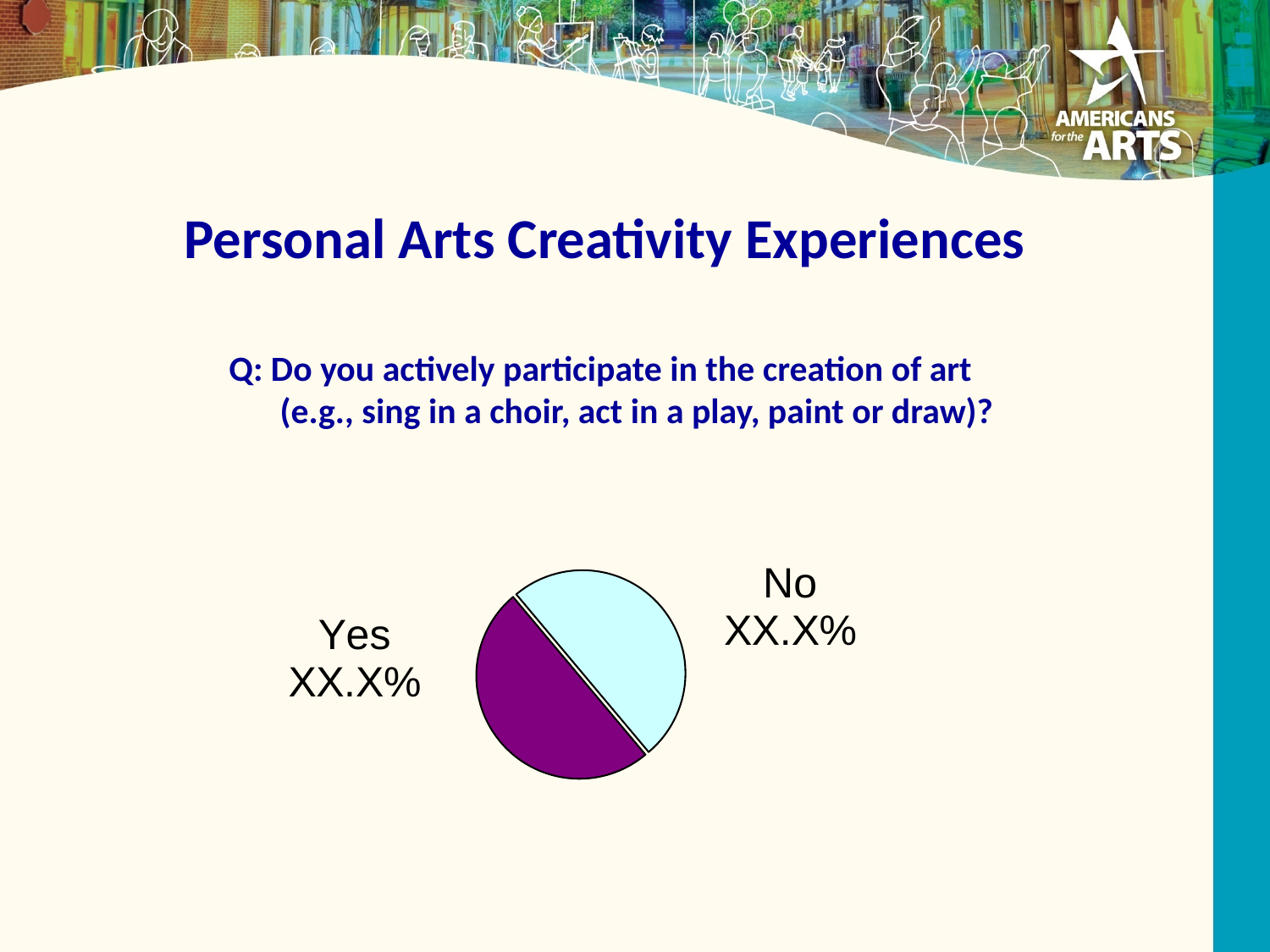
What data label is printed next to the No slice of the pie chart? XX.X% What data label is printed next to the Yes slice of the pie chart? XX.X% What kind of chart is shown on the slide? pie chart How many slices does the pie chart have? 2 What are the two categories labelled on the pie chart? Yes and No What colour is the Yes slice of the pie chart? purple